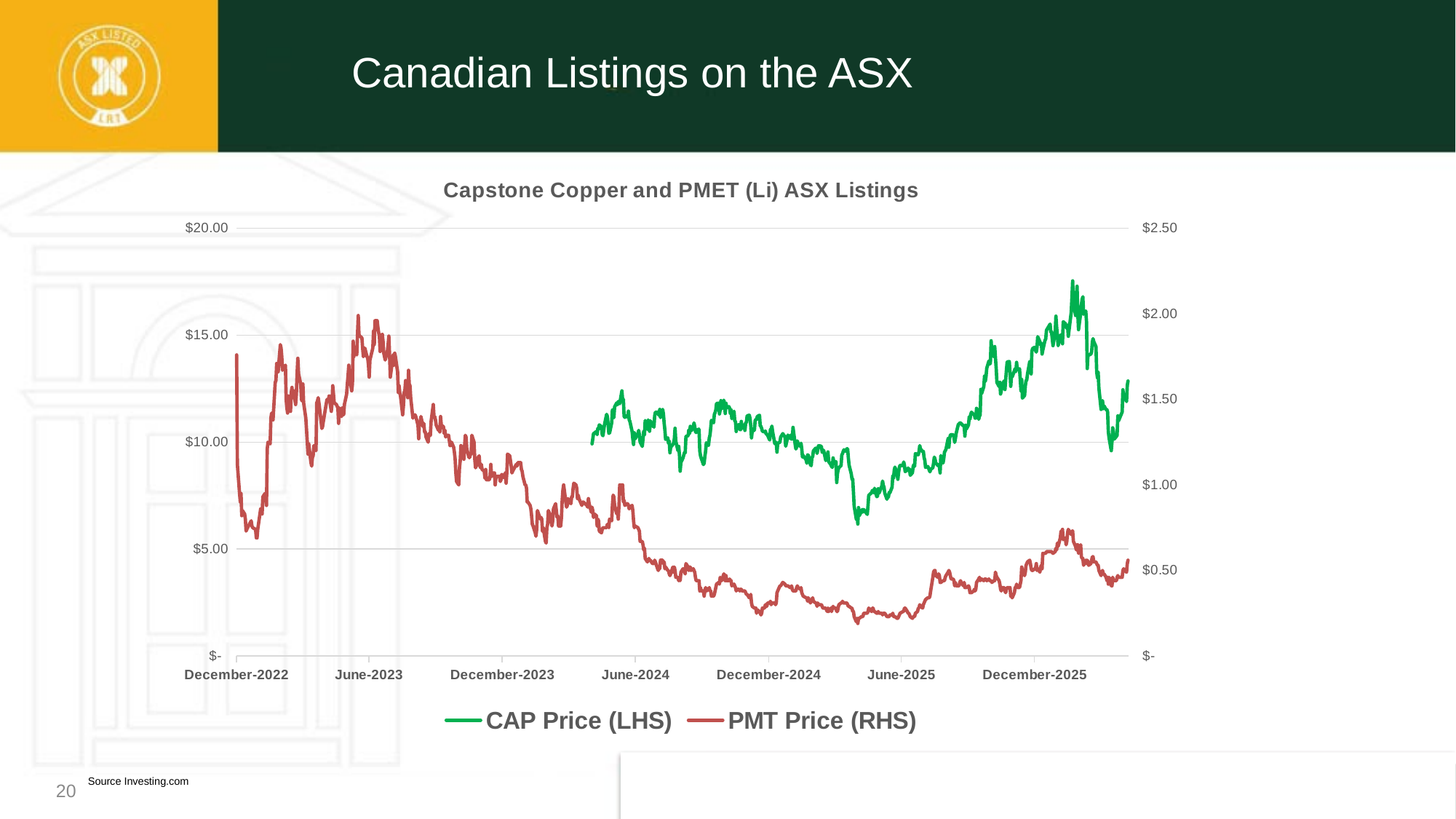
Is the PMT Price (RHS) value at June-2025 greater or less than $0.50? less What kind of chart is shown on the slide? Line chart What is the highest value shown on the right-hand axis? $2.50 Is the CAP Price (LHS) value at June-2025 greater or less than $15.00? less What is the title of the chart? Capstone Copper and PMET (Li) ASX Listings Which colour is used for the PMT Price (RHS) line? Red Is the PMT Price (RHS) value at December-2022 greater or less than $1.00? greater How many date labels are shown on the x axis? 7 How many series does the legend list? 2 Does the CAP Price (LHS) line rise or fall between June-2025 and December-2025? Rise Does the PMT Price (RHS) line rise or fall between June-2023 and June-2024? Fall